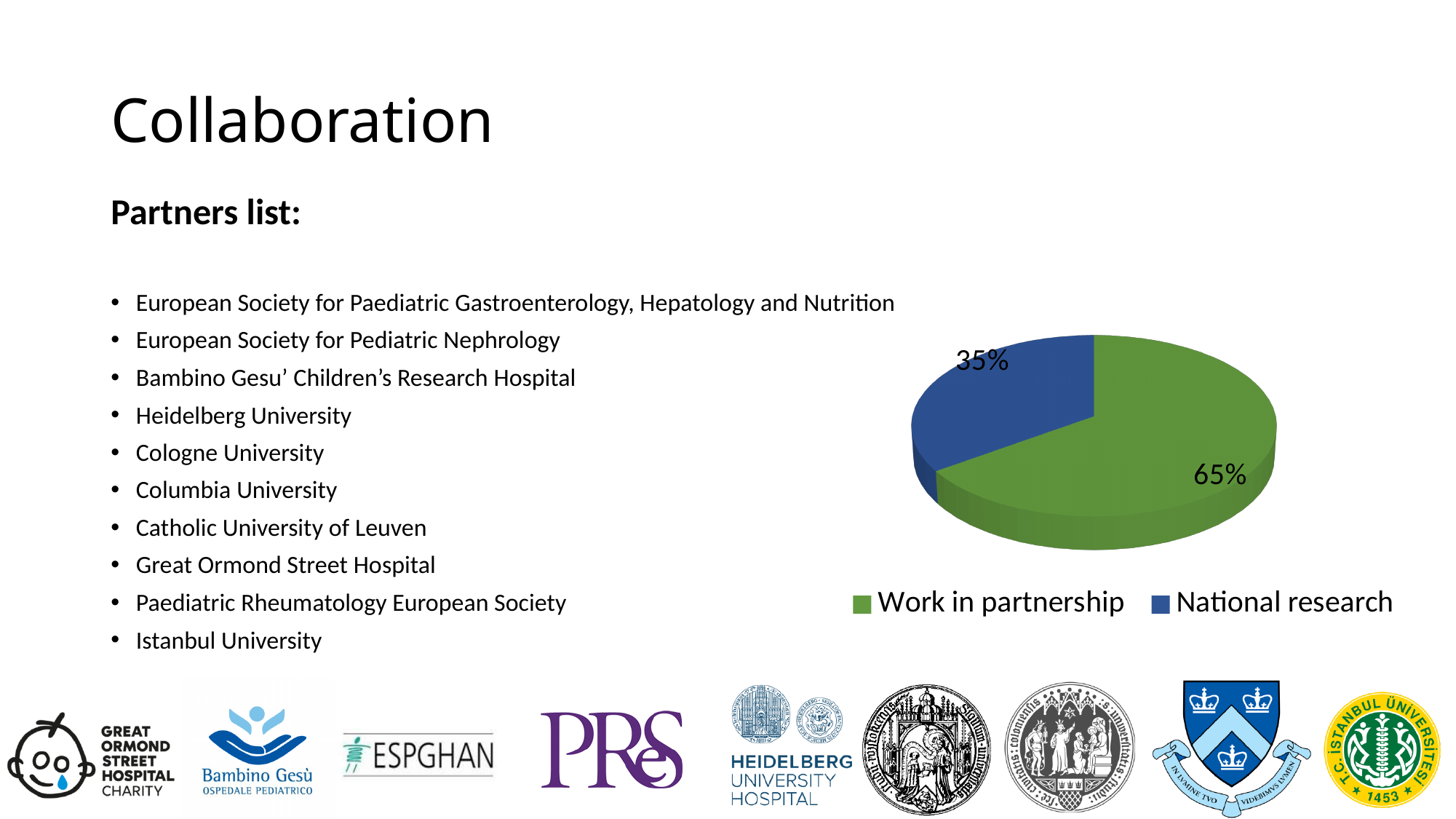
What colour is the "Work in partnership" slice in the pie chart? Green How many entries does the pie chart's legend list? 2 What percentage of the pie chart is labelled "Work in partnership"? 65% What percentage of the pie chart is labelled "National research"? 35% What share of the pie does the "National research" slice represent? 35% Which is larger in the pie chart, "Work in partnership" or "National research"? Work in partnership Which slice of the pie chart is the largest? Work in partnership How many slices does the pie chart have? 2 What kind of chart is shown on the slide? Pie chart Which slice of the pie chart is the smallest? National research What colour is the "National research" slice in the pie chart? Blue What is the difference in percentage points between the "Work in partnership" and "National research" slices? 30